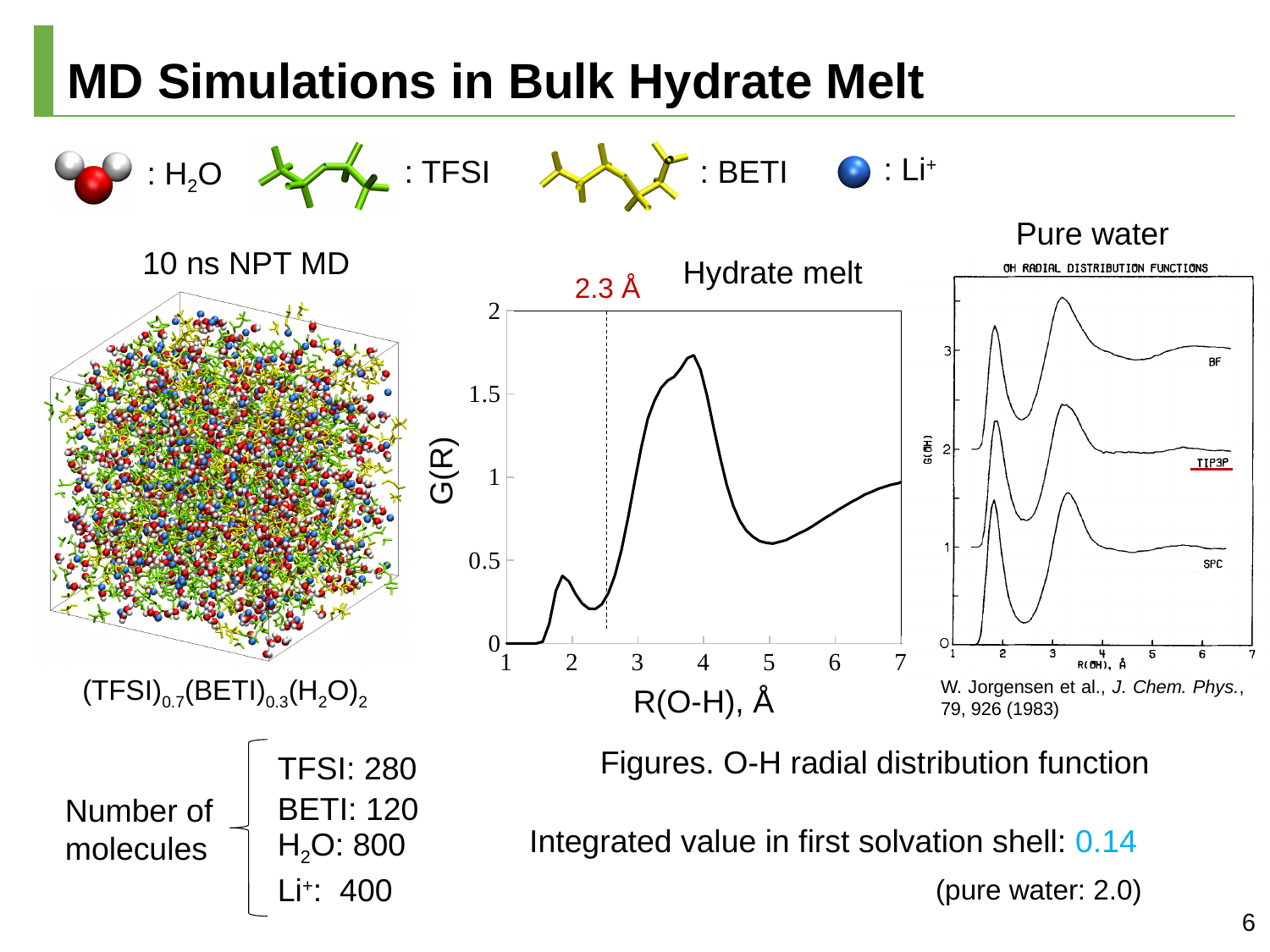
How many curves are plotted in the 'Pure water' chart? 3 In the 'Hydrate melt' chart, at what distance is the vertical dashed line drawn? 2.3 Å What kind of chart is the 'Hydrate melt' chart? line chart In the 'Hydrate melt' chart, is the maximum value of G(R) greater or less than 1.5? greater In the 'Hydrate melt' chart, what is the label of the x axis? R(O-H), Å In the 'Hydrate melt' chart, does G(R) rise or fall as R(O-H) goes from 5 Å to 7 Å? rise In the 'Hydrate melt' chart, is the value of G(R) at R(O-H) = 5 Å greater or less than 1? less In the 'Pure water' chart, which curve label is underlined in red? TIP3P In the 'Hydrate melt' chart, what is the label of the y axis? G(R) In the 'Hydrate melt' chart, is the value of G(R) at the dashed line (2.3 Å) greater or less than 0.5? less In the 'Hydrate melt' chart, does G(R) rise or fall as R(O-H) goes from 4 Å to 5 Å? fall How many curves are plotted in the 'Hydrate melt' chart? 1